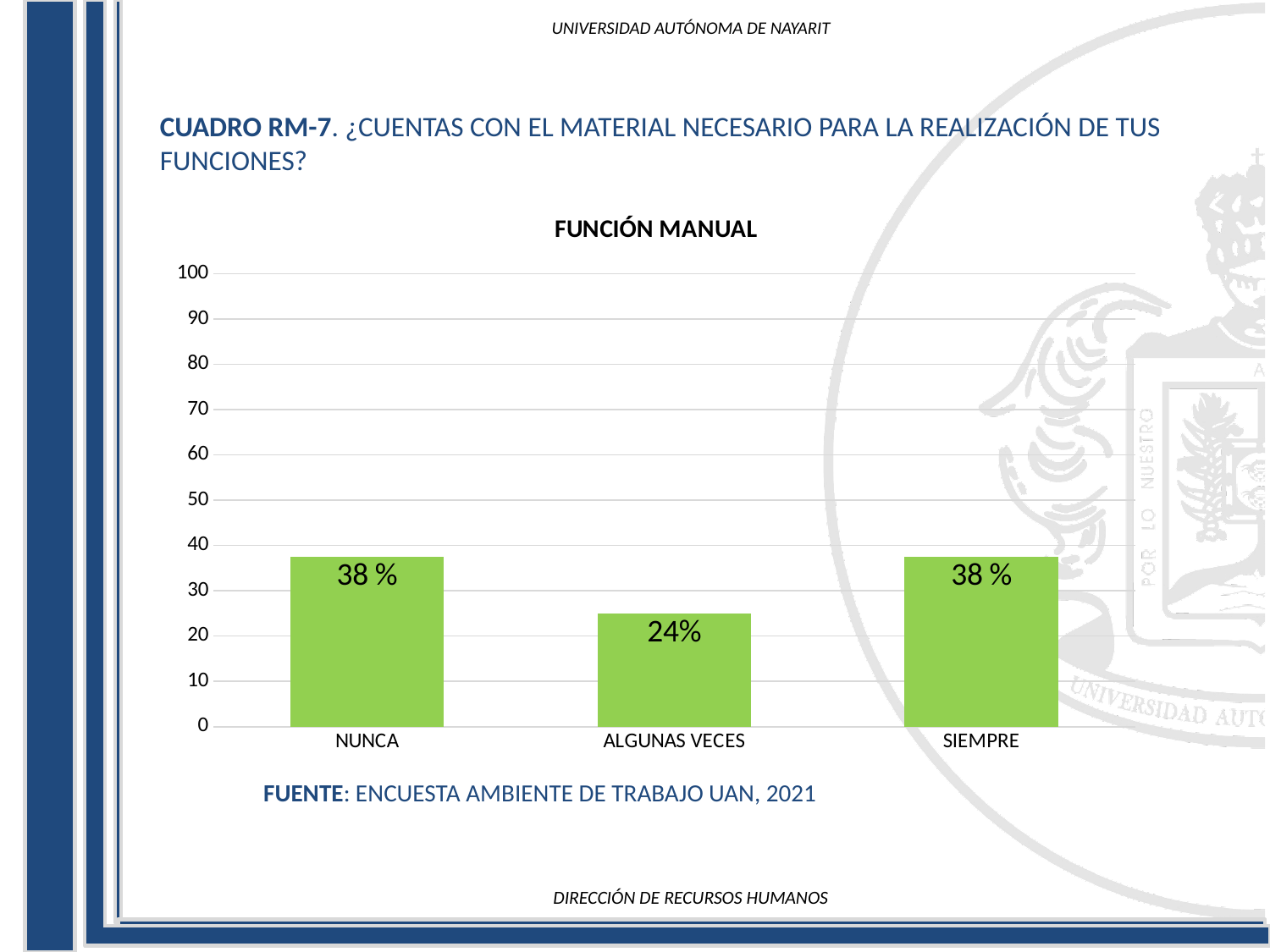
What is the highest value shown on the y axis? 100 What is the value for SIEMPRE? 38 % Which category has the lowest value? ALGUNAS VECES Which is larger, the value for SIEMPRE or the value for ALGUNAS VECES? SIEMPRE What is the difference between the values for NUNCA and ALGUNAS VECES? 14 What is the value for ALGUNAS VECES? 24% What is the title of the chart? FUNCIÓN MANUAL Is the value for ALGUNAS VECES greater or less than 30? less What kind of chart is shown? bar chart Is the value for NUNCA greater or less than 30? greater What is the value for NUNCA? 38 % How many categories are shown on the x axis? 3